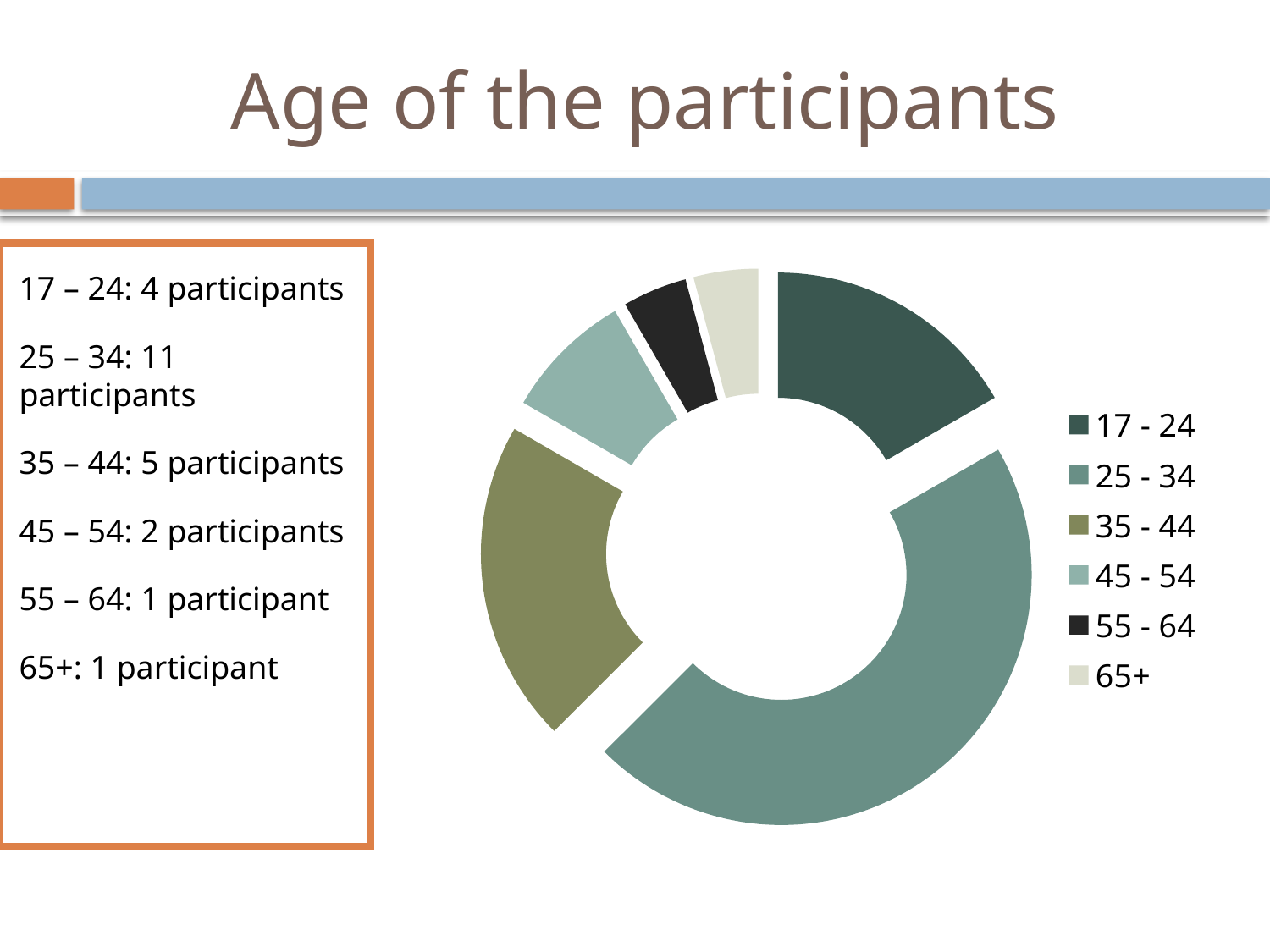
Which age group has the largest slice of the chart? 25 - 34 What is the difference in participants between the 35 - 44 and 45 - 54 age groups? 3 What kind of chart is shown on the slide? doughnut chart How many participants are in the 25 - 34 age group? 11 participants Which age group has more participants, 17 - 24 or 35 - 44? 35 - 44 What is the title of the slide containing the chart? Age of the participants How many participants are in the 45 - 54 age group? 2 participants How many participants are in the 17 - 24 age group? 4 participants How many participants are in the 55 - 64 age group? 1 participant Which legend entry is shown in the darkest (black) colour? 55 - 64 What is the difference in participants between the 25 - 34 and 17 - 24 age groups? 7 How many age categories does the chart show? 6